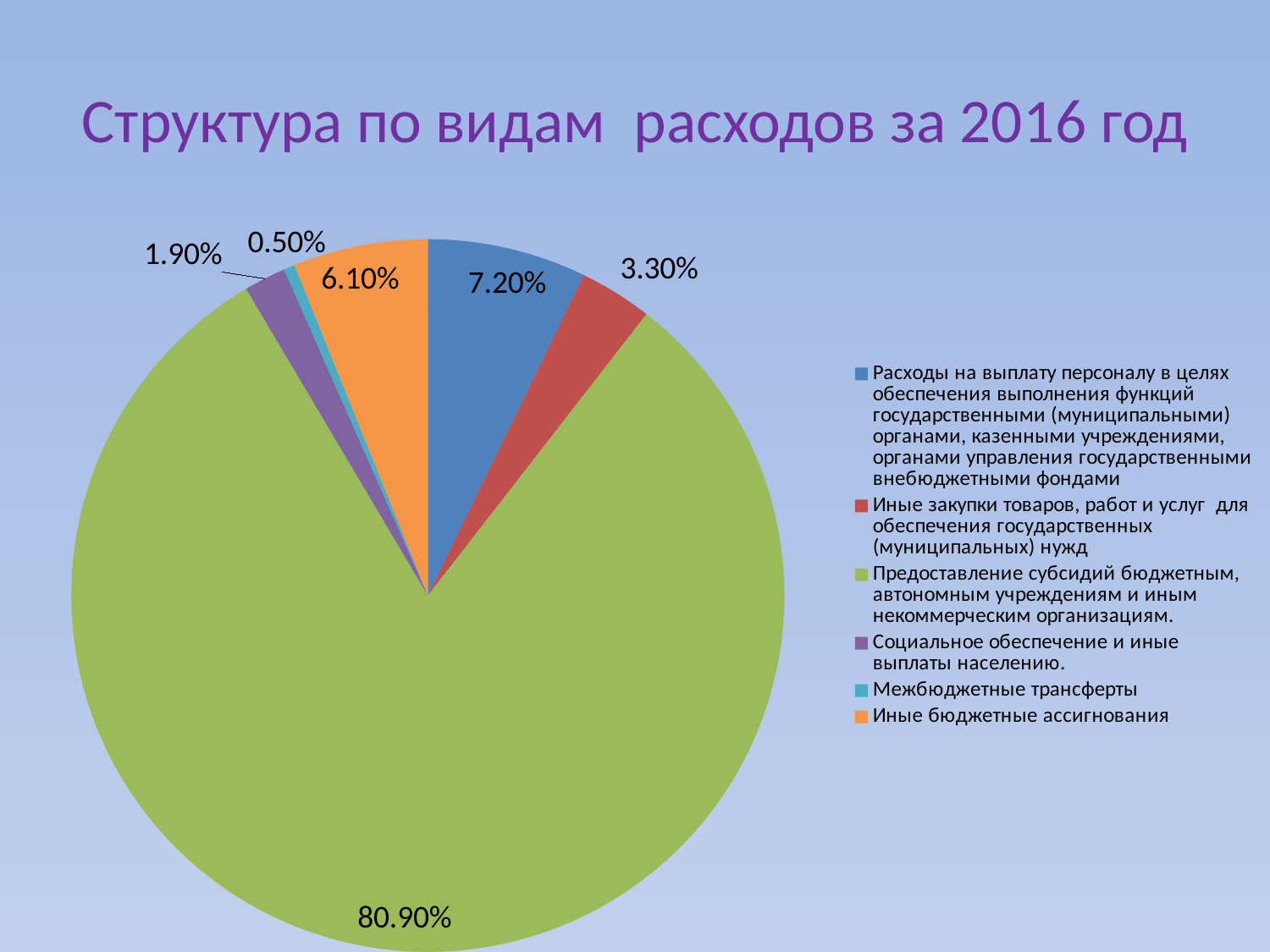
Which is larger: the share for "Иные бюджетные ассигнования" or the share for "Социальное обеспечение и иные выплаты населению"? Иные бюджетные ассигнования How many categories does the pie chart have? 6 What is the share for "Социальное обеспечение и иные выплаты населению"? 1.90% What is the share for "Межбюджетные трансферты"? 0.50% What is the share for "Иные бюджетные ассигнования"? 6.10% What is the title of the chart slide? Структура по видам расходов за 2016 год What type of chart is shown on the slide? Pie chart What is the difference between the share for "Расходы на выплату персоналу..." (7.20%) and the share for "Иные закупки товаров, работ и услуг..." (3.30%)? 3.90% What is the share for "Предоставление субсидий бюджетным, автономным учреждениям и иным некоммерческим организациям"? 80.90% What is the share for "Иные закупки товаров, работ и услуг для обеспечения государственных (муниципальных) нужд"? 3.30% Which category has the largest share of the pie? Предоставление субсидий бюджетным, автономным учреждениям и иным некоммерческим организациям Which category has the smallest share of the pie? Межбюджетные трансферты